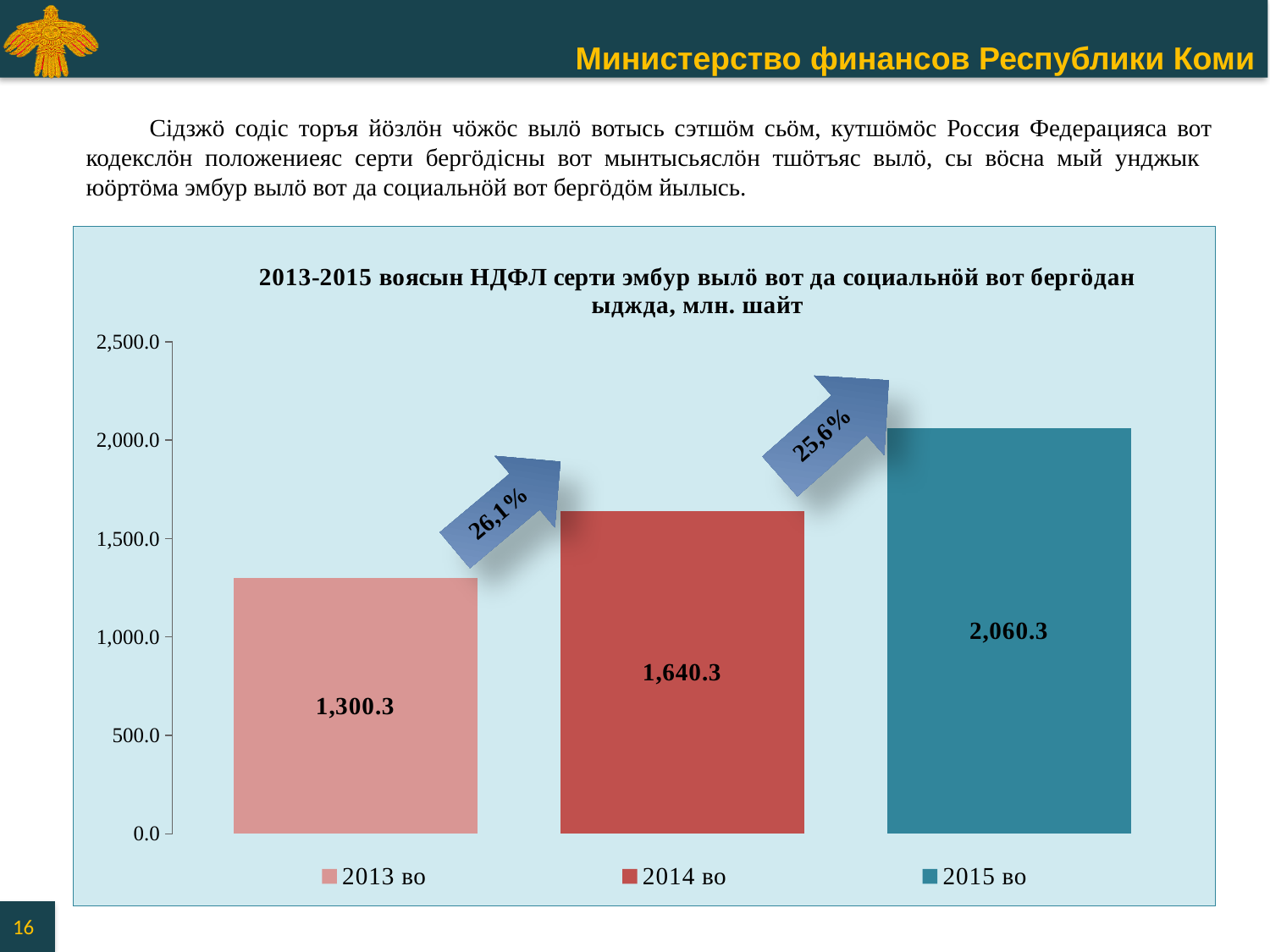
What is the value for 2015 во? 2,060.3 Which year has the highest value? 2015 во What is the value for 2014 во? 1,640.3 Which is larger, the value for 2013 во or the value for 2014 во? 2014 во What is the difference between the values for 2015 во and 2014 во? 420.0 What kind of chart is shown on the slide? bar chart How many entries does the legend list? 3 What is the difference between the values for 2014 во and 2013 во? 340.0 Which year has the lowest value? 2013 во How many bars are plotted in the chart? 3 What is the value for 2013 во? 1,300.3 Is the value for 2015 во greater or less than 2,000.0? greater